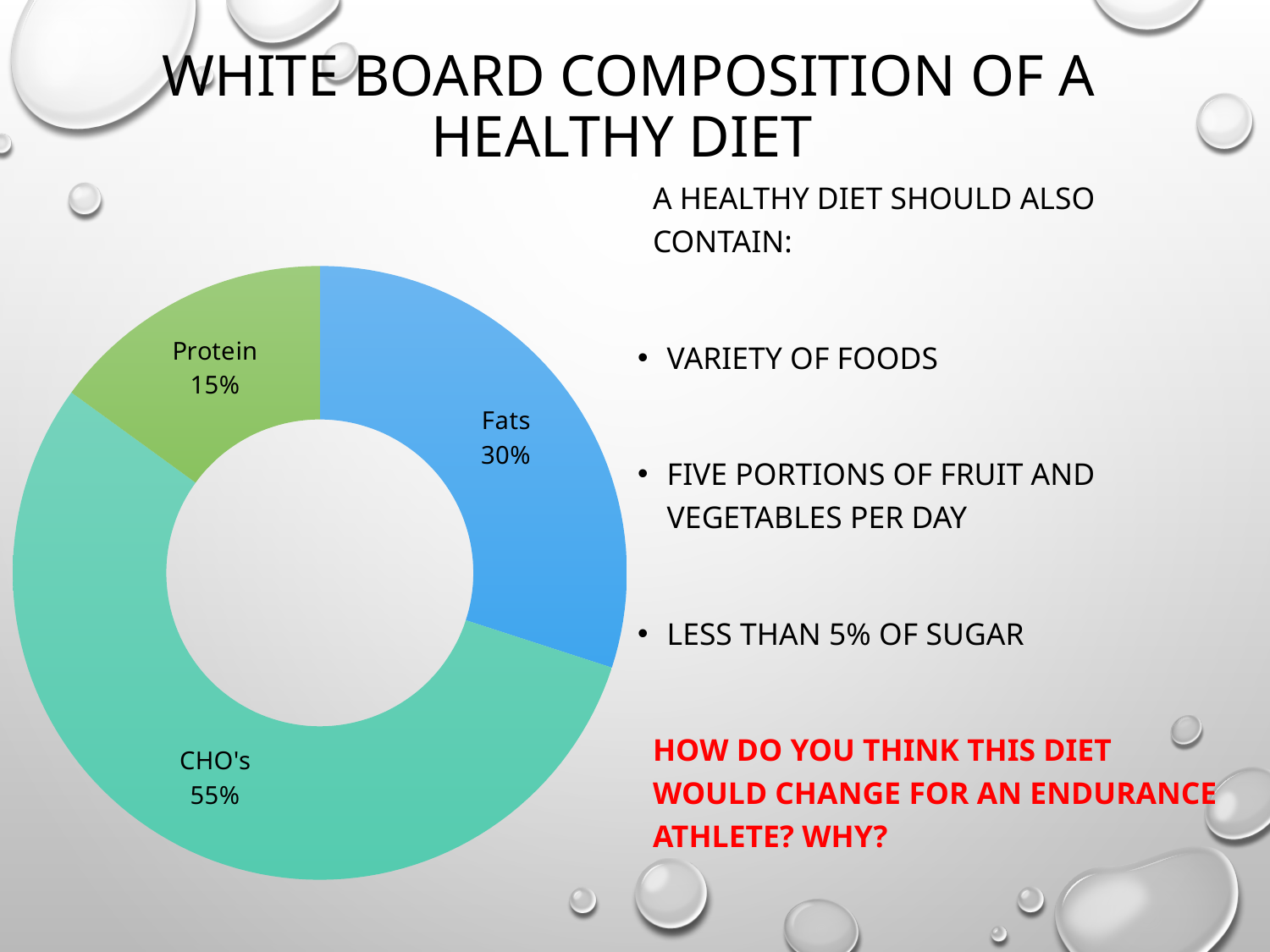
Which category has the largest share of the chart? CHO's How many categories are shown in the chart? 3 What percentage of the diet is shown for Fats? 30% Which category has the smallest share of the chart? Protein What percentage of the diet is shown for Protein? 15% What colour is the CHO's segment of the chart? Teal/green What percentage of the diet is shown for CHO's? 55% What kind of chart is shown on the slide? Doughnut (pie) chart Which is larger, the share for Fats or the share for Protein? Fats What is the difference in percentage points between Fats and Protein? 15 What is the difference in percentage points between CHO's and Fats? 25 What colour is the Fats segment of the chart? Blue